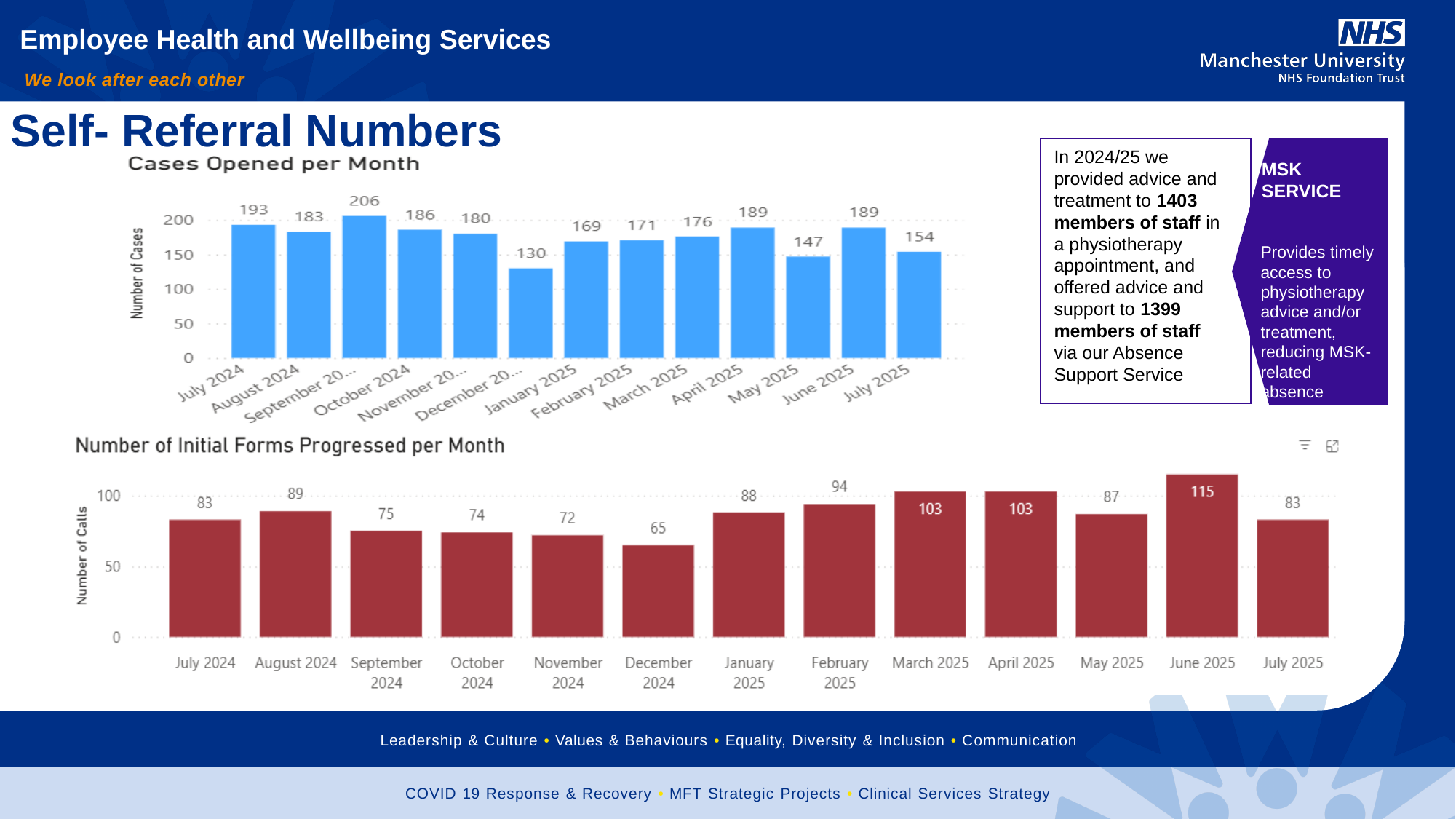
What type of chart is the 'Number of Initial Forms Progressed per Month' chart? Bar chart In the 'Number of Initial Forms Progressed per Month' chart, which is larger, the value for August 2024 or the value for May 2025? August 2024 In the 'Cases Opened per Month' chart, is the value for May 2025 greater or less than 150? less In the 'Number of Initial Forms Progressed per Month' chart, which month has the lowest value? December 2024 In the 'Cases Opened per Month' chart, what is the value for October 2024? 186 In the 'Cases Opened per Month' chart, which month has the highest number of cases? September 2024 In the 'Number of Initial Forms Progressed per Month' chart, what is the value for February 2025? 94 In the 'Cases Opened per Month' chart, what is the difference between the values for July 2024 and July 2025? 39 In the 'Number of Initial Forms Progressed per Month' chart, which month has the highest value? June 2025 In the 'Cases Opened per Month' chart, how many months are plotted? 13 In the 'Number of Initial Forms Progressed per Month' chart, what is the difference between the values for June 2025 and July 2025? 32 In the 'Cases Opened per Month' chart, which month has the lowest number of cases? December 2024